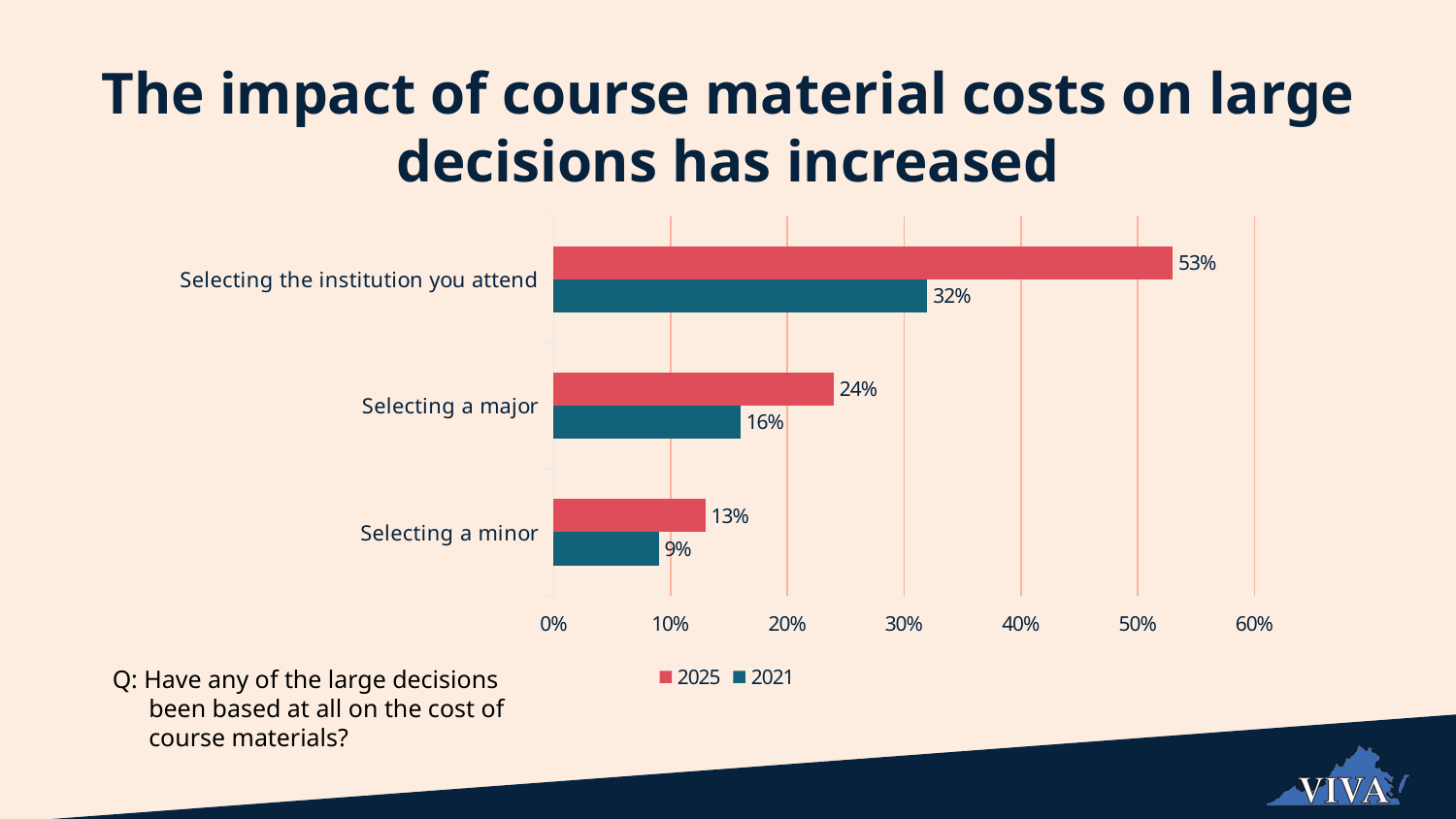
How many categories are shown on the chart? 3 Which is larger: the 2025 value for 'Selecting a minor' or the 2021 value for 'Selecting a major'? 2021 value for 'Selecting a major' How many series does the legend list? 2 What is the difference between the 2025 and 2021 values for 'Selecting the institution you attend'? 21% Which category has the lowest 2021 value? Selecting a minor What kind of chart is shown on the slide? Bar chart What is the 2025 value for 'Selecting the institution you attend'? 53% Is the 2021 value for 'Selecting the institution you attend' greater or less than 30%? greater Which category has the highest 2025 value? Selecting the institution you attend What is the difference between the 2025 and 2021 values for 'Selecting a major'? 8% What is the 2021 value for 'Selecting a major'? 16% What is the 2021 value for 'Selecting a minor'? 9%